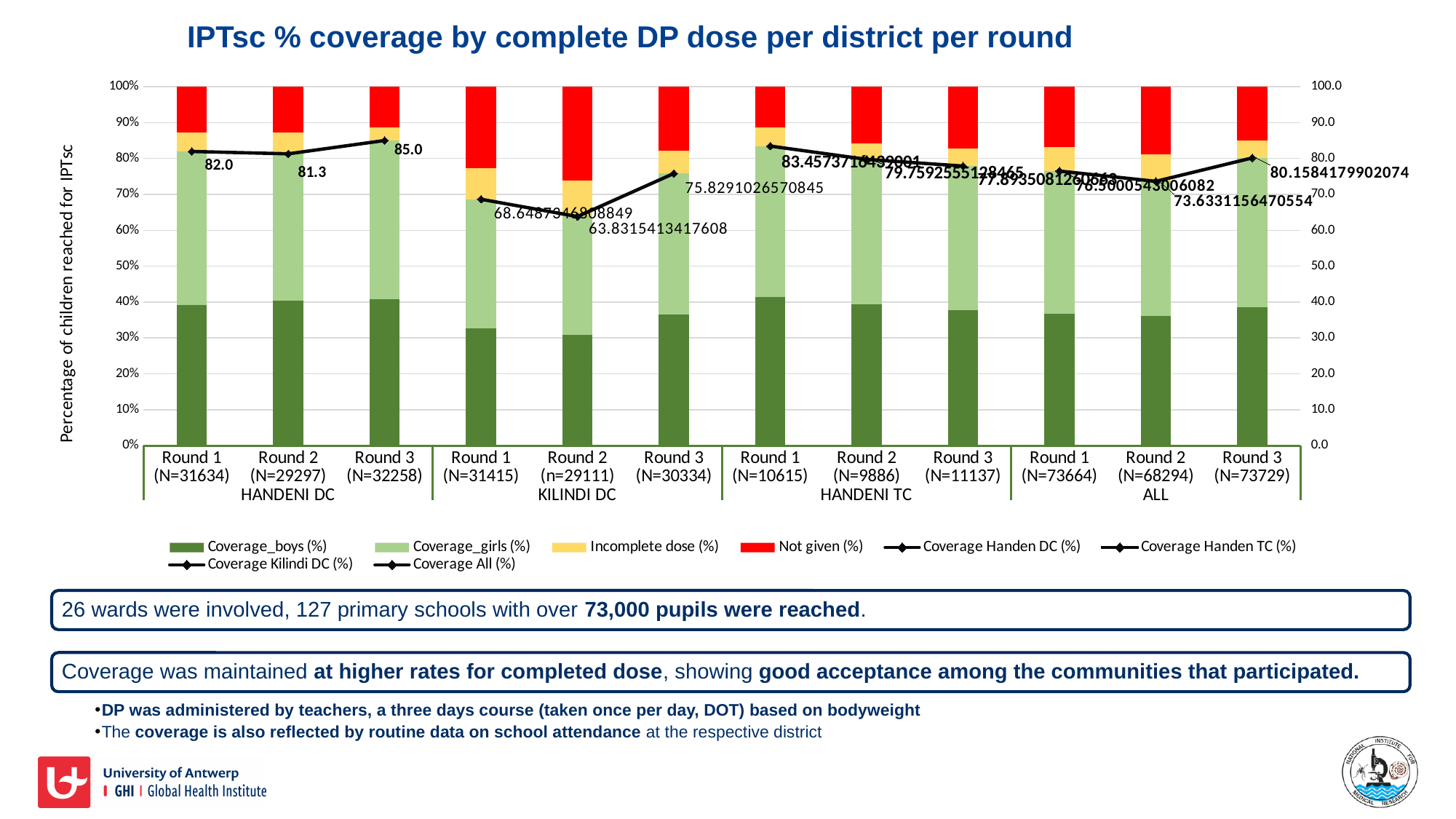
What is the Coverage All (%) value for Round 2 in the ALL group? 73.6331156470554 Which round has the lowest coverage line value on the chart? Round 2 in KILINDI DC What is the Coverage Kilindi DC (%) value for Round 2 in KILINDI DC? 63.8315413417608 How many stacked bars are plotted on the chart? 12 Is the Coverage_boys (%) value for Round 2 in KILINDI DC greater or less than 40%? less What is the Coverage Kilindi DC (%) value for Round 3 in KILINDI DC? 75.8291026570845 How many series does the legend list? 8 By how much does the Coverage Handen DC (%) value for Round 3 exceed that for Round 1 in HANDENI DC? 3.0 What is the Coverage All (%) value for Round 3 in the ALL group? 80.1584179902074 What is the Coverage Handen DC (%) value for Round 3 in HANDENI DC? 85.0 What is the Coverage Handen DC (%) value for Round 2 in HANDENI DC? 81.3 What is the Coverage Handen DC (%) value for Round 1 in HANDENI DC? 82.0